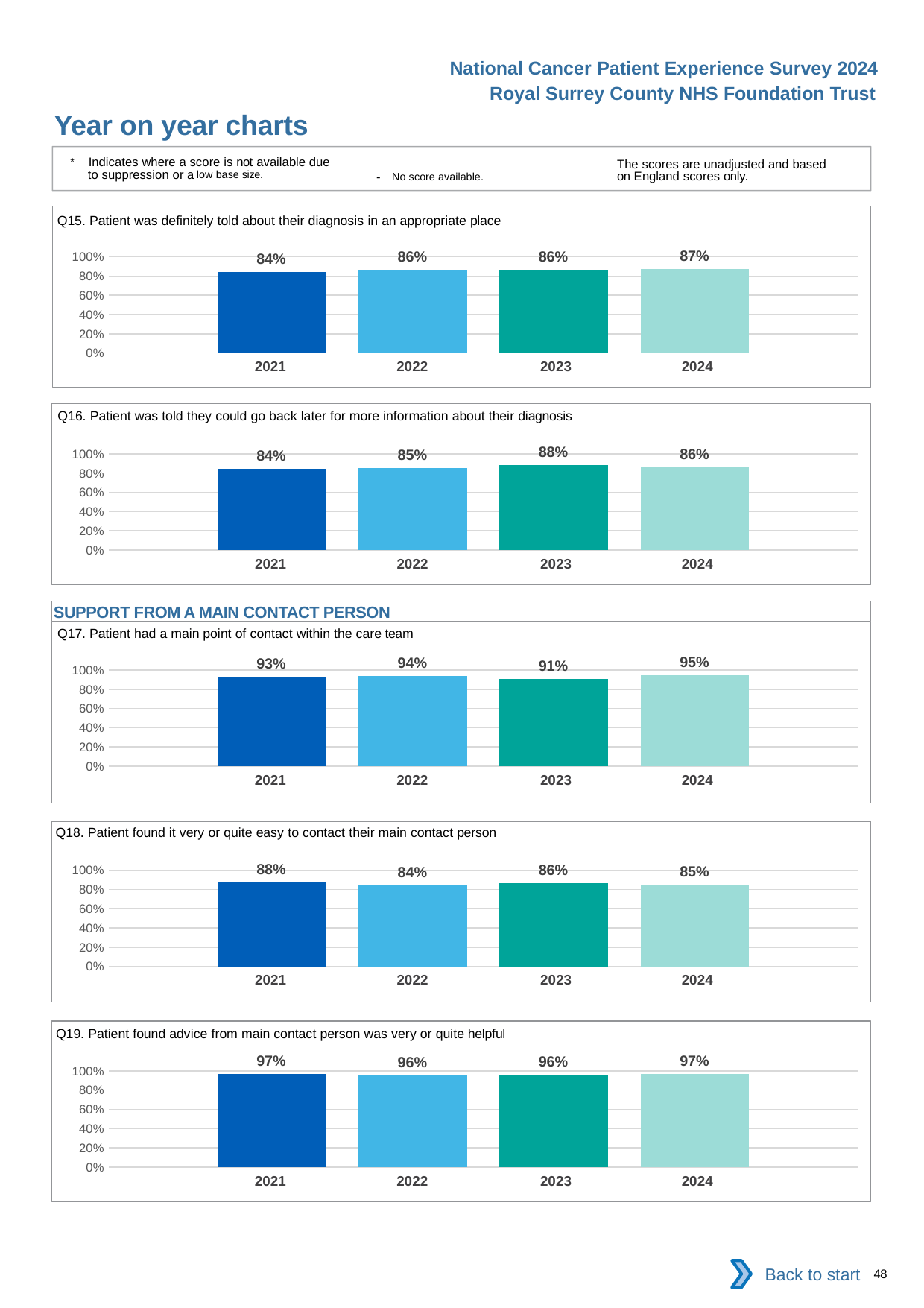
In the Q16 chart (Patient was told they could go back later for more information about their diagnosis), which year has the highest value? 2023 What kind of chart is the Q16 chart (Patient was told they could go back later for more information about their diagnosis)? Bar chart In the Q19 chart (Patient found advice from main contact person was very or quite helpful), what is the value for 2022? 96% In the Q15 chart (Patient was definitely told about their diagnosis in an appropriate place), how many years are plotted? 4 In the Q17 chart (Patient had a main point of contact within the care team), which year has the lowest value? 2023 In the Q16 chart (Patient was told they could go back later for more information about their diagnosis), what is the difference between the 2023 and 2024 values? 2% In the Q17 chart (Patient had a main point of contact within the care team), which is larger, the value for 2022 or the value for 2024? 2024 In the Q18 chart (Patient found it very or quite easy to contact their main contact person), is the value for 2021 greater or less than 80%? greater In the Q18 chart (Patient found it very or quite easy to contact their main contact person), what is the difference between the 2021 and 2022 values? 4% What is the section heading shown above the Q17 chart? SUPPORT FROM A MAIN CONTACT PERSON In the Q15 chart (Patient was definitely told about their diagnosis in an appropriate place), what is the value for 2024? 87% In the Q15 chart (Patient was definitely told about their diagnosis in an appropriate place), do the values generally rise or fall from 2021 to 2024? Rise